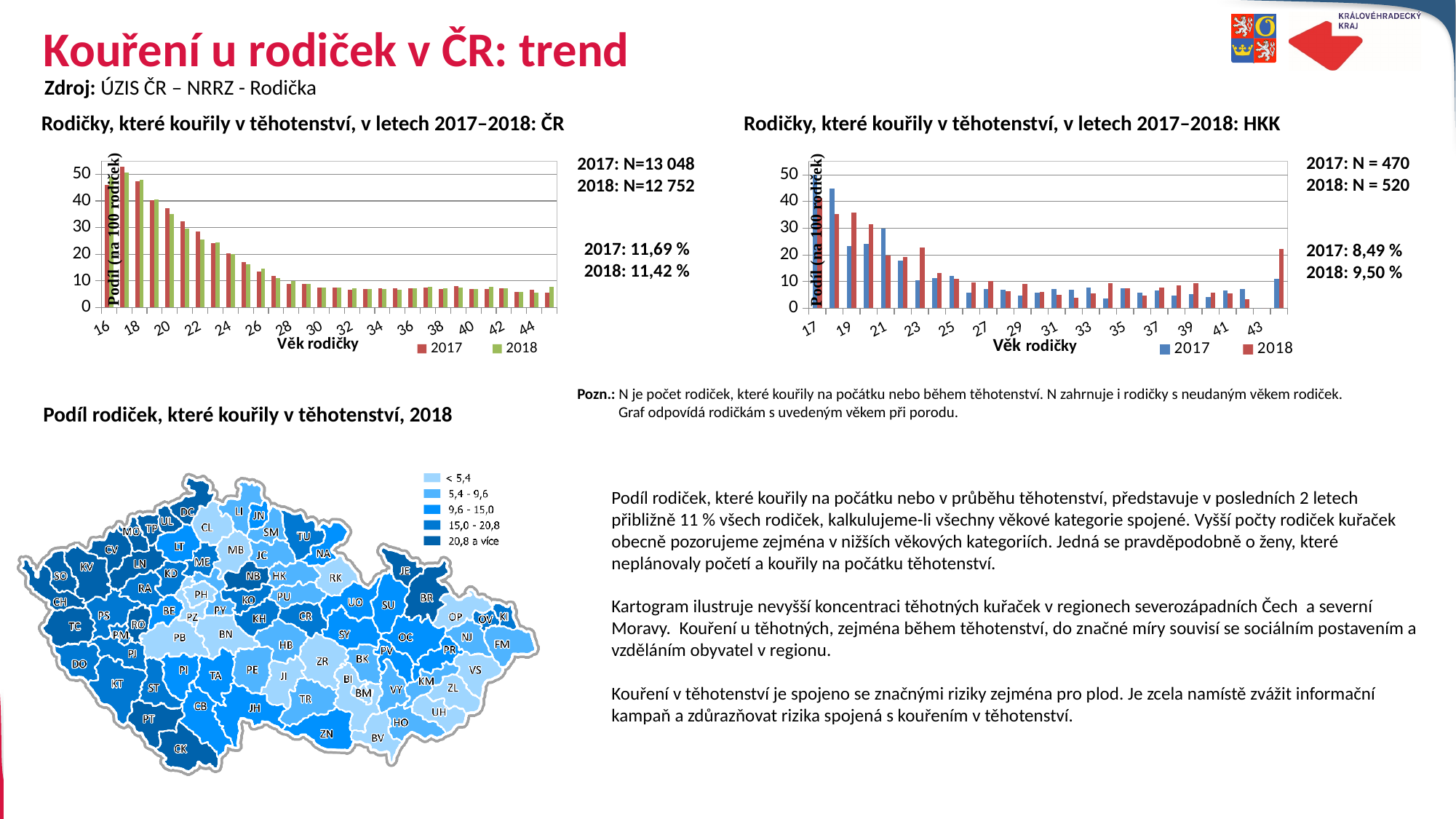
In the chart titled "Rodičky, které kouřily v těhotenství, v letech 2017–2018: ČR", do the values generally rise or fall as the age of the mother (Věk rodičky) increases? fall In the chart titled "Rodičky, které kouřily v těhotenství, v letech 2017–2018: HKK", which age has the highest value for the 2017 series? 17 In the chart titled "Rodičky, které kouřily v těhotenství, v letech 2017–2018: ČR", is the 2017 value for age 30 greater or less than 10? less What kind of chart is the chart titled "Rodičky, které kouřily v těhotenství, v letech 2017–2018: ČR"? bar chart In the chart titled "Rodičky, které kouřily v těhotenství, v letech 2017–2018: ČR", is the 2017 value for age 20 greater or less than 30? greater What is the label of the vertical axis of the chart titled "Rodičky, které kouřily v těhotenství, v letech 2017–2018: ČR"? Podíl (na 100 rodiček) In the chart titled "Rodičky, které kouřily v těhotenství, v letech 2017–2018: HKK", is the 2017 value for age 35 greater or less than 10? less In the chart titled "Rodičky, které kouřily v těhotenství, v letech 2017–2018: ČR", which series does the legend list besides 2017? 2018 How many series does the legend of the chart titled "Rodičky, které kouřily v těhotenství, v letech 2017–2018: HKK" list? 2